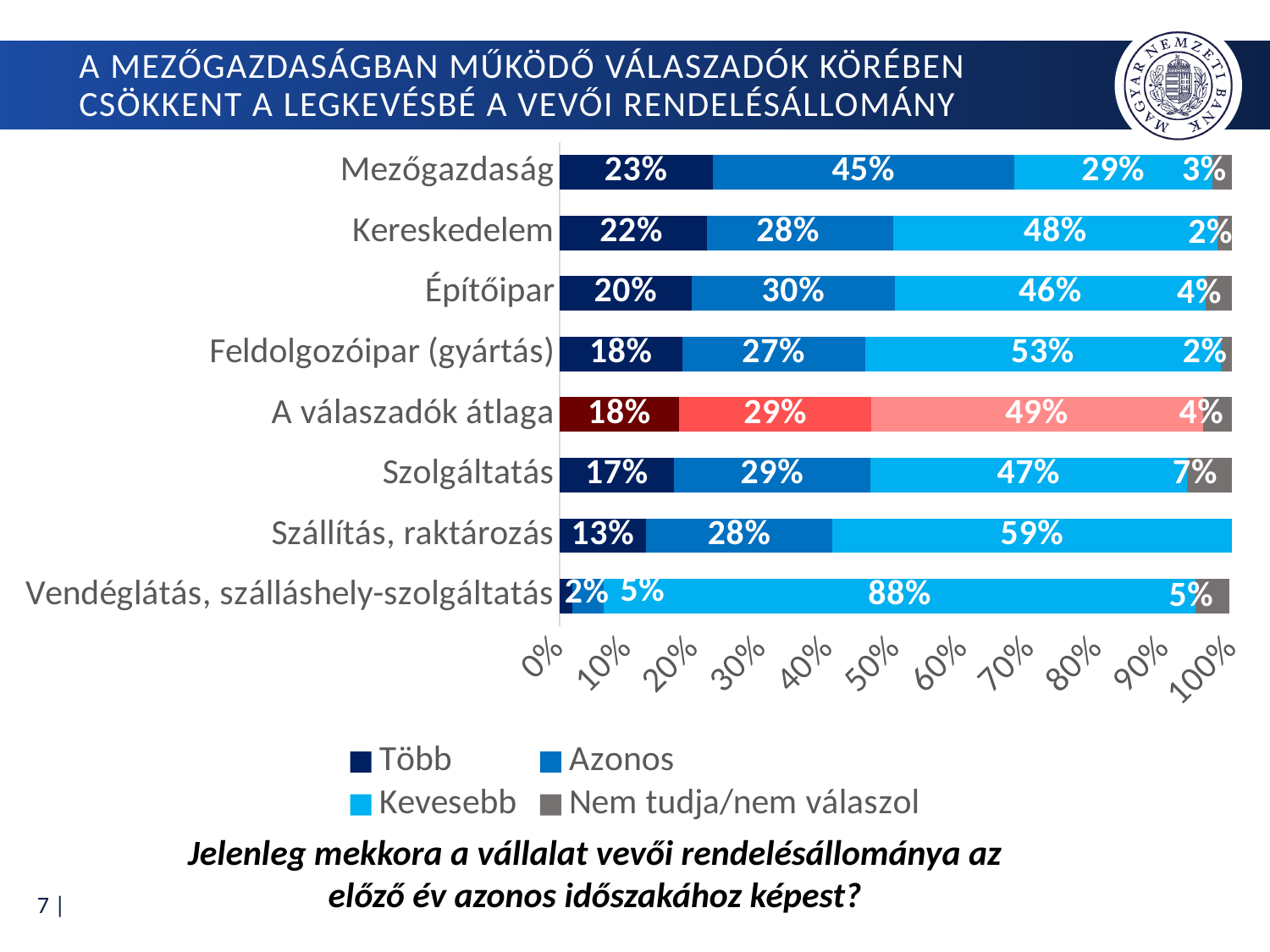
How many series does the legend list? 4 Which category has the highest "Kevesebb" value? Vendéglátás, szálláshely-szolgáltatás What is the "Nem tudja/nem válaszol" value for Szolgáltatás? 7% Which is larger: the "Kevesebb" value for Szállítás, raktározás or the "Kevesebb" value for Szolgáltatás? Szállítás, raktározás What is the "Azonos" value for Építőipar? 30% What kind of chart is shown on the slide? Stacked bar chart How many categories are shown on the chart? 8 What is the "Több" value for Mezőgazdaság? 23% Which category has the lowest "Több" value? Vendéglátás, szálláshely-szolgáltatás Which legend entry is shown in grey? Nem tudja/nem válaszol What is the difference between the "Azonos" value for Mezőgazdaság and the "Azonos" value for Kereskedelem? 17% What is the "Kevesebb" value for Feldolgozóipar (gyártás)? 53%